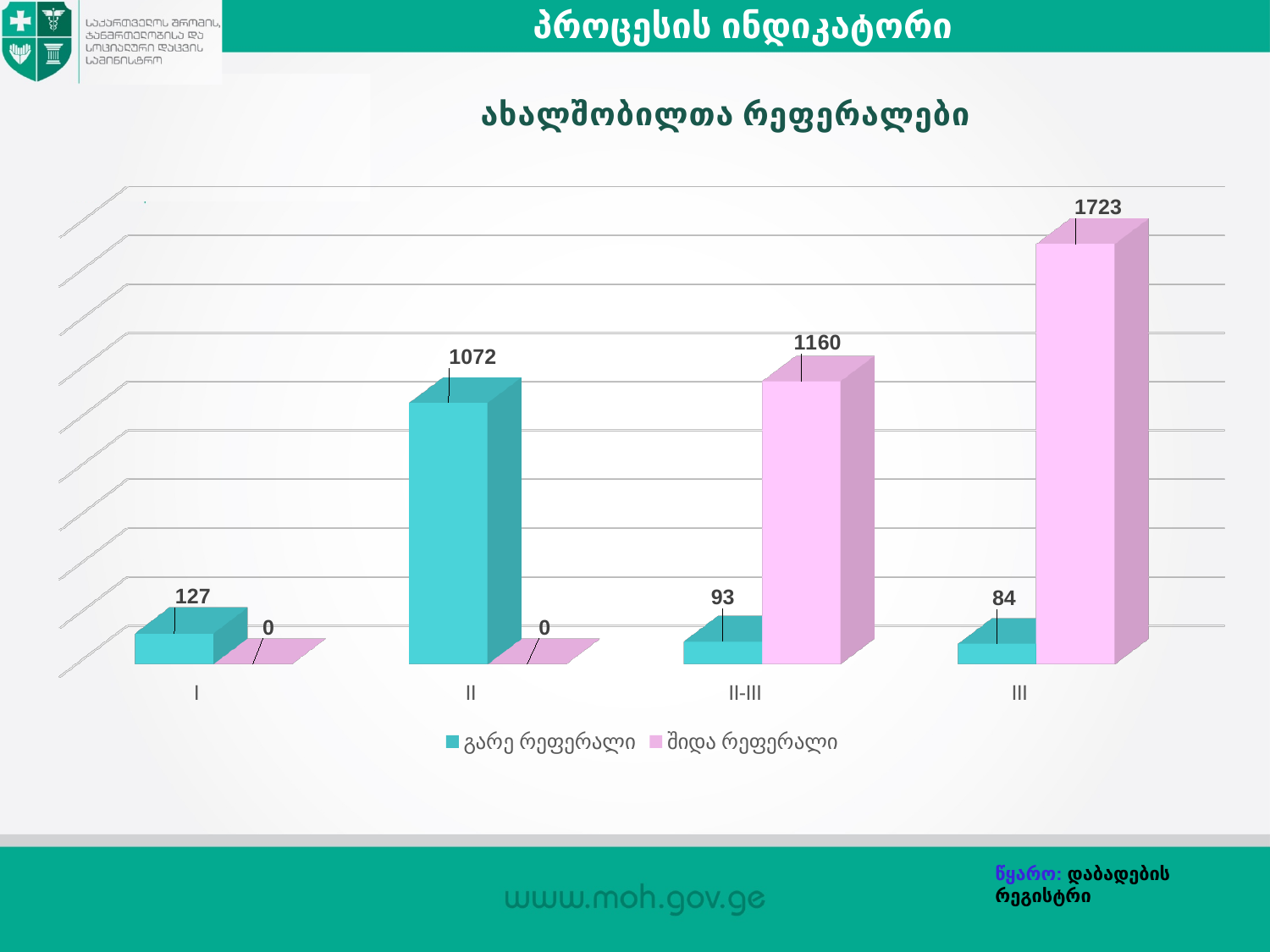
What is the value of შიდა რეფერალი for category I? 0 What is the value of გარე რეფერალი for category II? 1072 For category II-III, which series has the larger value, გარე რეფერალი or შიდა რეფერალი? შიდა რეფერალი Which category has the highest value for შიდა რეფერალი? III How many series does the legend list? 2 What is the value of გარე რეფერალი for category II-III? 93 Which category has the lowest value for გარე რეფერალი? III What is the title of the chart? ახალშობილთა რეფერალები What is the value of შიდა რეფერალი for category III? 1723 What kind of chart is shown on the slide? Bar chart What is the difference between შიდა რეფერალი and გარე რეფერალი for category III? 1639 How many categories are shown on the x axis? 4